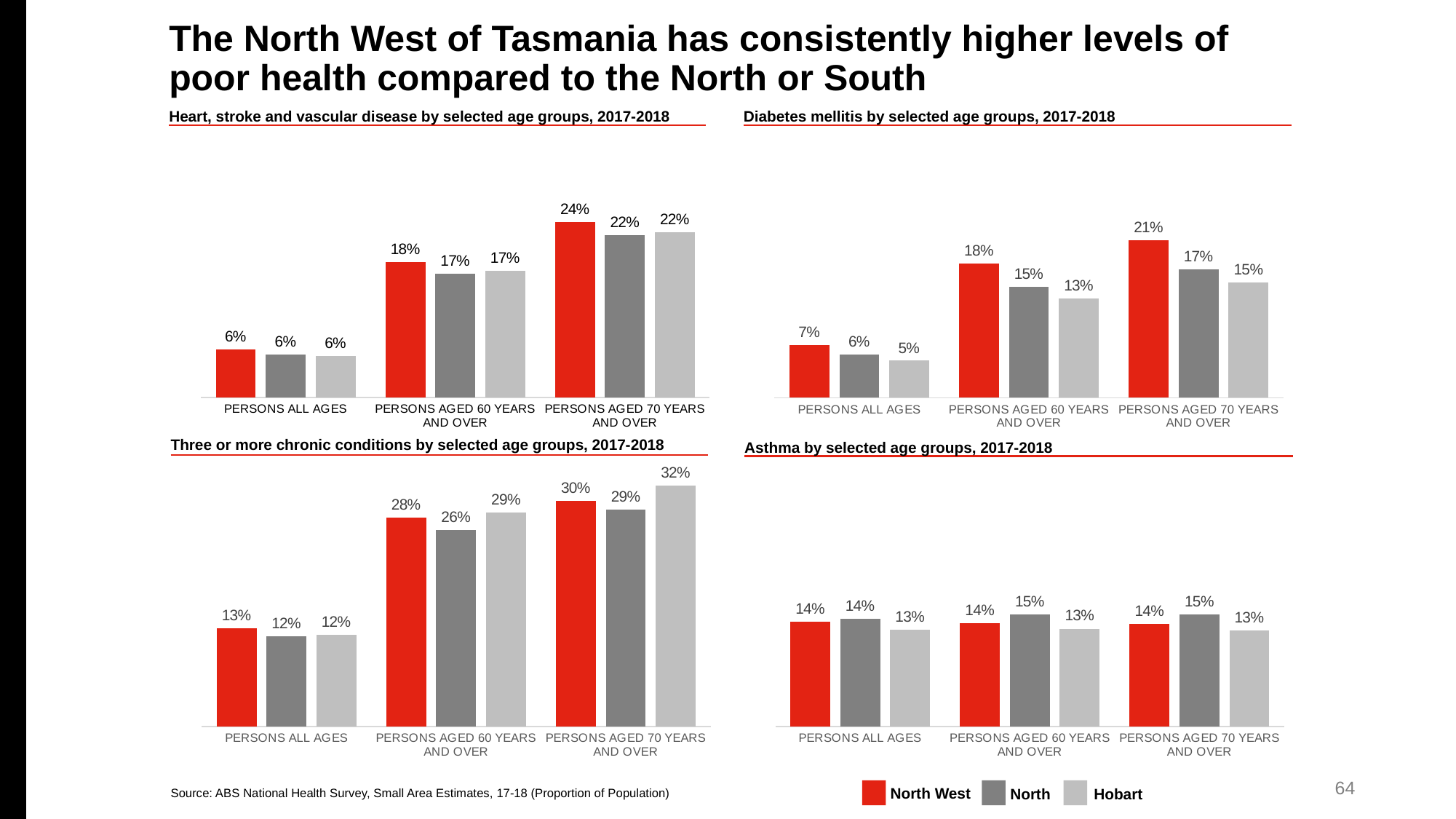
In the 'Diabetes mellitis by selected age groups, 2017-2018' chart, which region has the lowest value among persons all ages? Hobart In the 'Heart, stroke and vascular disease by selected age groups, 2017-2018' chart, what is the value for North West among persons aged 70 years and over? 24% In the 'Asthma by selected age groups, 2017-2018' chart, what is the value for North among persons aged 60 years and over? 15% How many age group categories are shown on the x axis of the 'Asthma by selected age groups, 2017-2018' chart? 3 In the 'Diabetes mellitis by selected age groups, 2017-2018' chart, what is the value for Hobart among persons aged 60 years and over? 13% In the 'Diabetes mellitis by selected age groups, 2017-2018' chart, what is the difference between the North West and Hobart values for persons aged 70 years and over? 6% What type of chart is the 'Heart, stroke and vascular disease by selected age groups, 2017-2018' chart? Bar chart In the 'Heart, stroke and vascular disease by selected age groups, 2017-2018' chart, do the North West values rise or fall from persons all ages to persons aged 70 years and over? Rise Which colour represents North West in the legend? Red In the 'Three or more chronic conditions by selected age groups, 2017-2018' chart, which is larger for persons aged 60 years and over: North West or North? North West In the 'Three or more chronic conditions by selected age groups, 2017-2018' chart, which region has the highest value among persons aged 70 years and over? Hobart How many series does the legend at the bottom of the slide list? 3